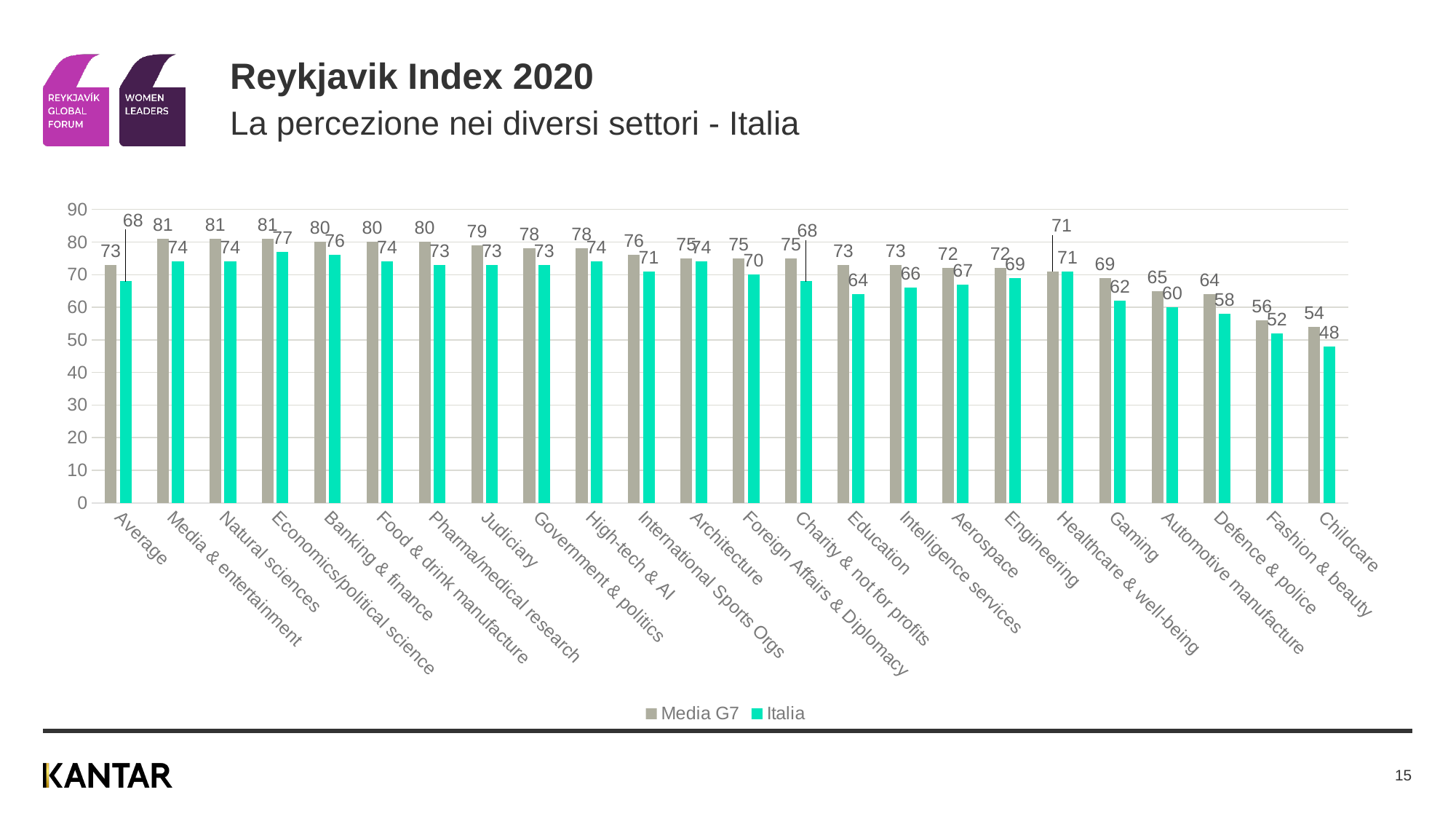
Which category has the highest Italia value? Economics/political science What is the Italia value for Childcare? 48 What is the Italia value for Economics/political science? 77 What is the difference between the Media G7 and Italia values for Education? 9 Do the Media G7 values generally rise or fall from left to right along the x axis? Fall Which is larger for Gaming, the Media G7 value or the Italia value? Media G7 Which category has the lowest Media G7 value? Childcare What kind of chart is shown on the slide? Bar chart How many series does the legend list? 2 How many categories are shown on the x axis? 24 What is the Media G7 value for Banking & finance? 80 What is the difference between the Media G7 and Italia values for Average? 5